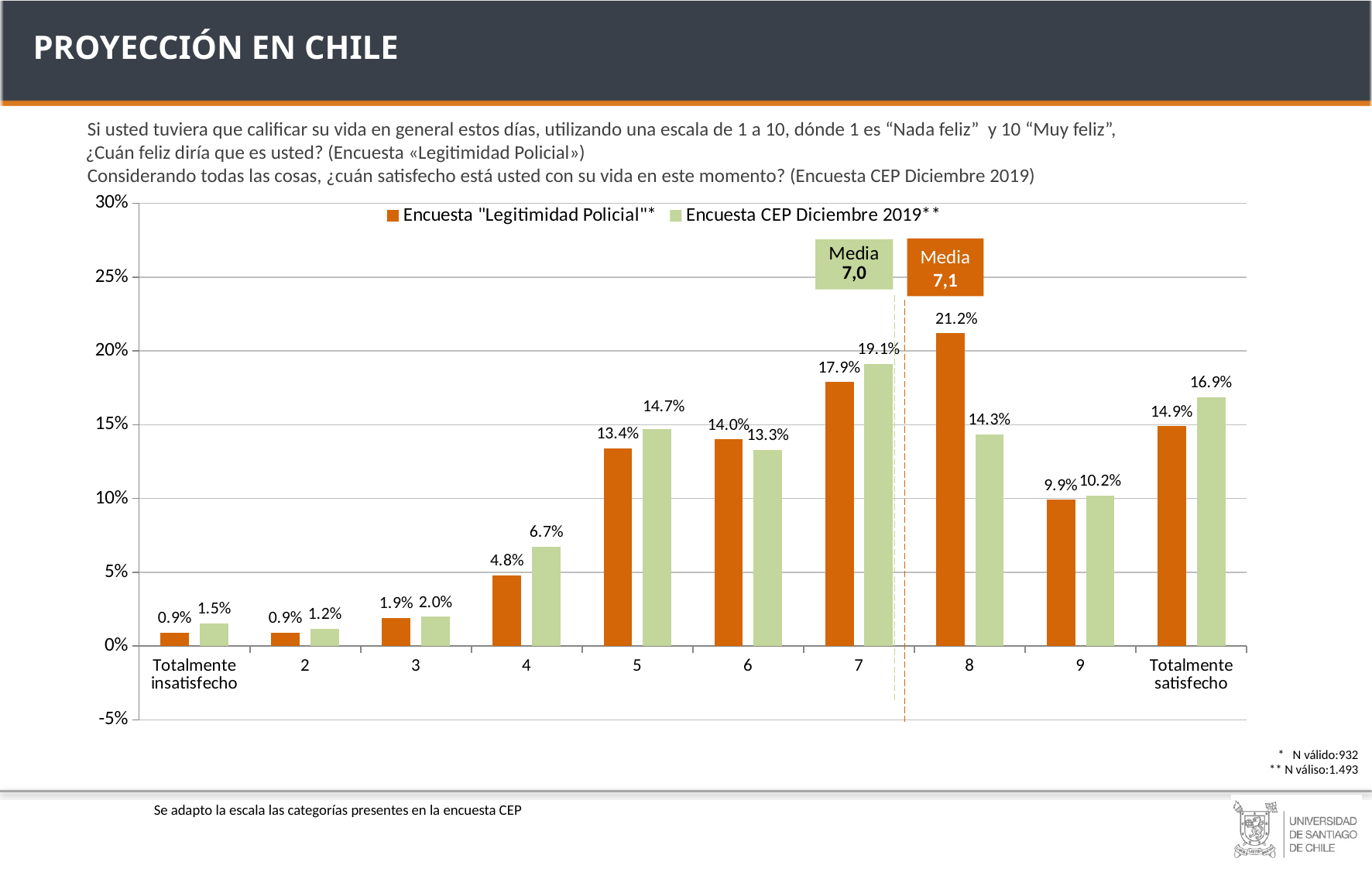
What is the value for category 8 in the Encuesta "Legitimidad Policial" series? 21.2% What mean (Media) is shown in the orange box for the Encuesta "Legitimidad Policial" series? 7,1 How many series does the legend list? 2 For category 6, which series has the larger value: Encuesta "Legitimidad Policial" or Encuesta CEP Diciembre 2019? Encuesta "Legitimidad Policial" How many categories are shown on the x axis? 10 What is the value for category 7 in the Encuesta CEP Diciembre 2019 series? 19.1% What is the value for category 4 in the Encuesta "Legitimidad Policial" series? 4.8% What is the difference between the Encuesta "Legitimidad Policial" and Encuesta CEP Diciembre 2019 values for category 8? 6.9% Which category has the highest value in the Encuesta "Legitimidad Policial" series? 8 What kind of chart is shown on the slide? bar chart What is the value for "Totalmente satisfecho" in the Encuesta CEP Diciembre 2019 series? 16.9% Which category has the lowest value in the Encuesta CEP Diciembre 2019 series? 2